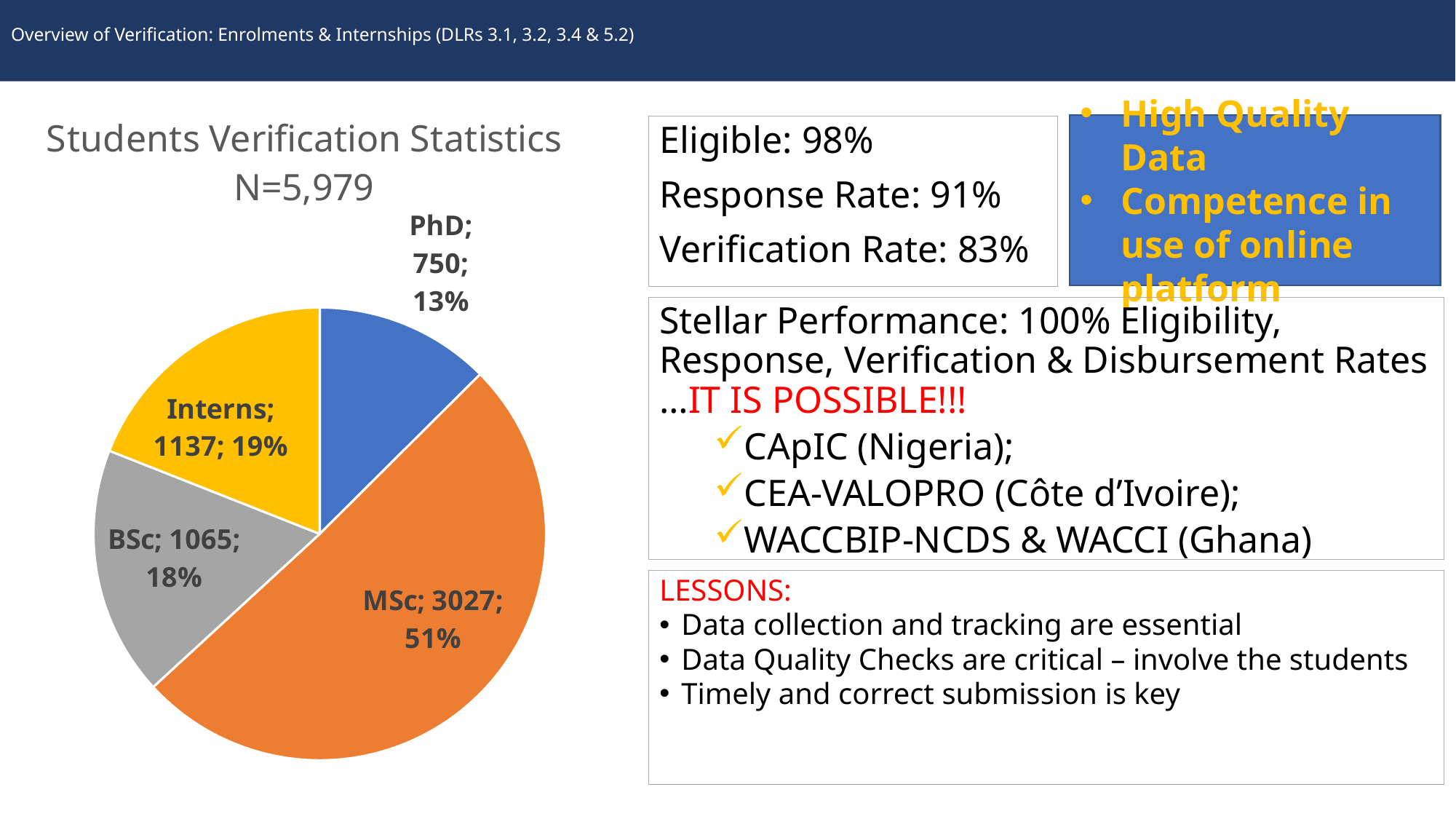
What is the difference between the values for Interns and BSc? 72 Which category has the largest slice? MSc What is the title of the chart? Students Verification Statistics N=5,979 What is the value for MSc? 3027 Which category has the smallest slice? PhD What share of the pie does MSc represent? 51% Which is larger, the value for Interns or the value for PhD? Interns How many slices does the pie chart have? 4 What is the value for Interns? 1137 What is the value for PhD? 750 What kind of chart is shown on the slide? pie chart What is the value for BSc? 1065